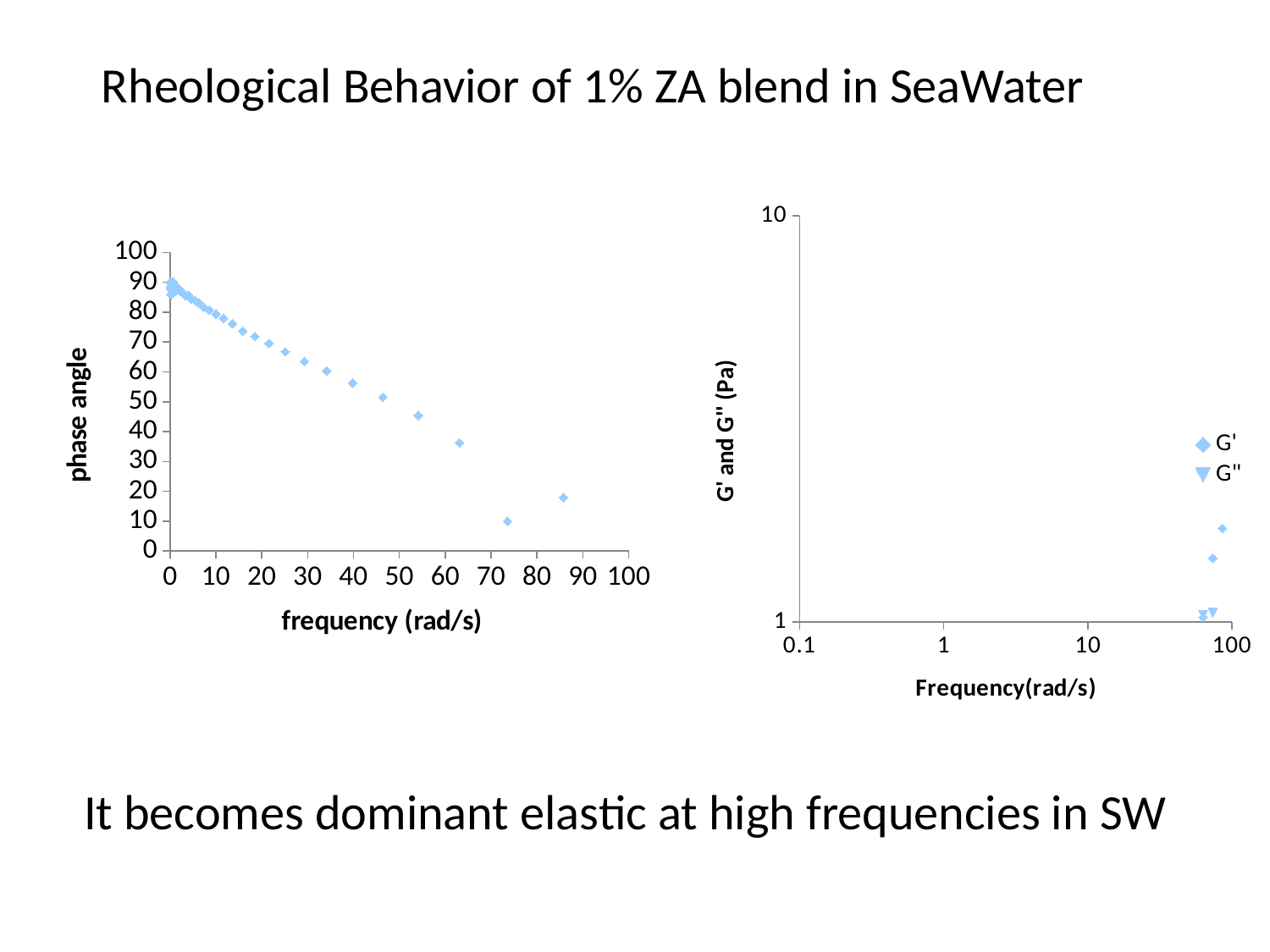
In the right chart, at the highest plotted frequency, which is larger, G' or G''? G' In the left chart, is the phase angle at a frequency of about 40 rad/s greater or less than 70? less In the left chart, does the phase angle rise or fall as frequency increases? fall In the left chart, is the phase angle at the highest plotted frequency greater or less than 30? less In the left chart, is the phase angle at the lowest frequencies greater or less than 80? greater What kind of chart is the left chart (phase angle vs frequency)? scatter chart How many series does the legend of the right chart list? 2 What kind of chart is the right chart (G' and G'' vs frequency)? scatter chart What are the legend entries of the right chart? G' and G'' What is the x-axis title of the left chart? frequency (rad/s)